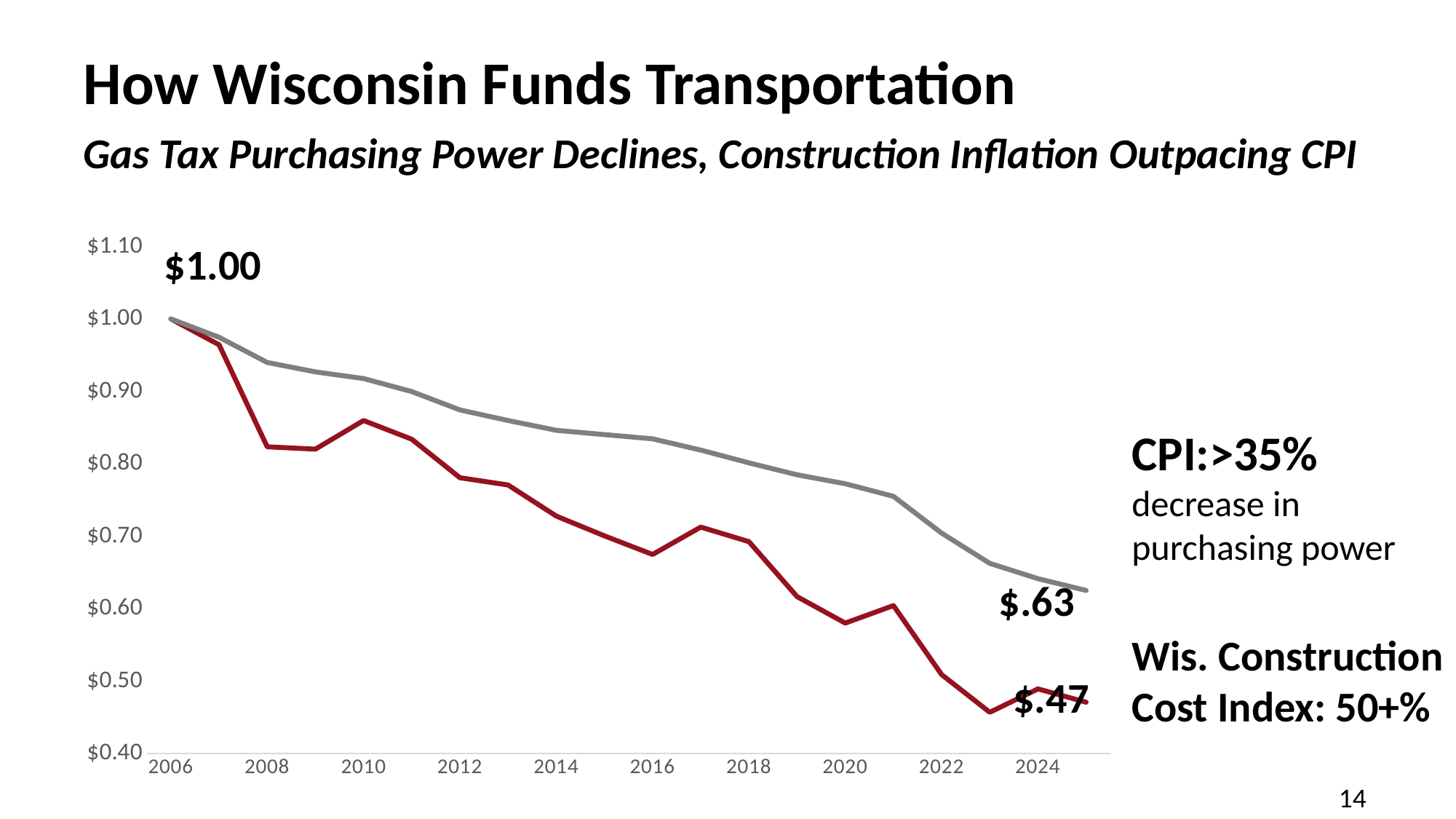
By how much did the CPI line fall from its $1.00 starting value to its $.63 ending value? $.37 What is the starting value of both lines in 2006? $1.00 What is the difference between the final labelled values of the CPI line ($.63) and the Wis. Construction Cost Index line ($.47)? $.16 Is the value of the red Wis. Construction Cost Index line in 2016 greater or less than $0.70? less What is the final labelled value of the red Wis. Construction Cost Index line? $.47 Is the value of the gray CPI line in 2016 greater or less than $0.80? greater How many lines (series) are plotted on the chart? 2 Do the values of the lines rise or fall from 2006 to 2024? fall What percentage decrease in purchasing power does the slide state for CPI? >35% What type of chart is shown on the slide? line chart Which line ends lower, the gray CPI line or the red Wis. Construction Cost Index line? red Wis. Construction Cost Index line What is the final labelled value of the gray CPI line? $.63